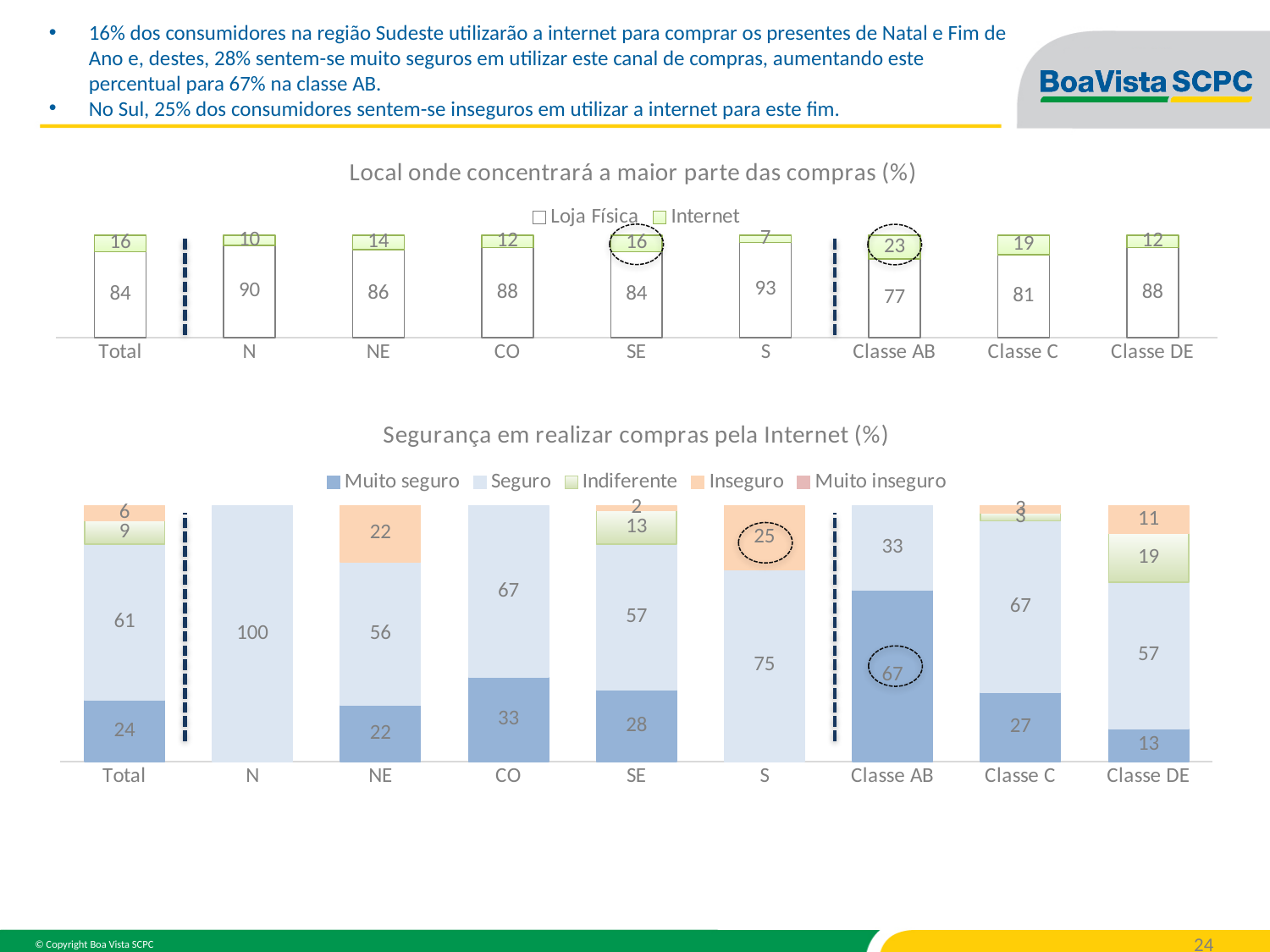
In the chart 'Segurança em realizar compras pela Internet (%)', what is the Muito seguro value for Classe AB? 67 In the chart 'Local onde concentrará a maior parte das compras (%)', which category has the highest Internet value? Classe AB In the chart 'Local onde concentrará a maior parte das compras (%)', what is the difference between the Loja Física values for N and Classe AB? 13 In the chart 'Segurança em realizar compras pela Internet (%)', what is the Inseguro value for S? 25 In the chart 'Local onde concentrará a maior parte das compras (%)', what is the Loja Física value for S? 93 In the chart 'Local onde concentrará a maior parte das compras (%)', how many series does the legend list? 2 In the chart 'Segurança em realizar compras pela Internet (%)', how many series does the legend list? 5 In the chart 'Segurança em realizar compras pela Internet (%)', which category has the lowest Muito seguro value among those with a Muito seguro label? Classe DE In the chart 'Local onde concentrará a maior parte das compras (%)', what is the Internet value for Classe AB? 23 In the chart 'Local onde concentrará a maior parte das compras (%)', which category has the lowest Internet value? S In the chart 'Segurança em realizar compras pela Internet (%)', is the Seguro value for NE larger or smaller than the Seguro value for CO? smaller What kind of chart is 'Segurança em realizar compras pela Internet (%)'? Stacked bar chart